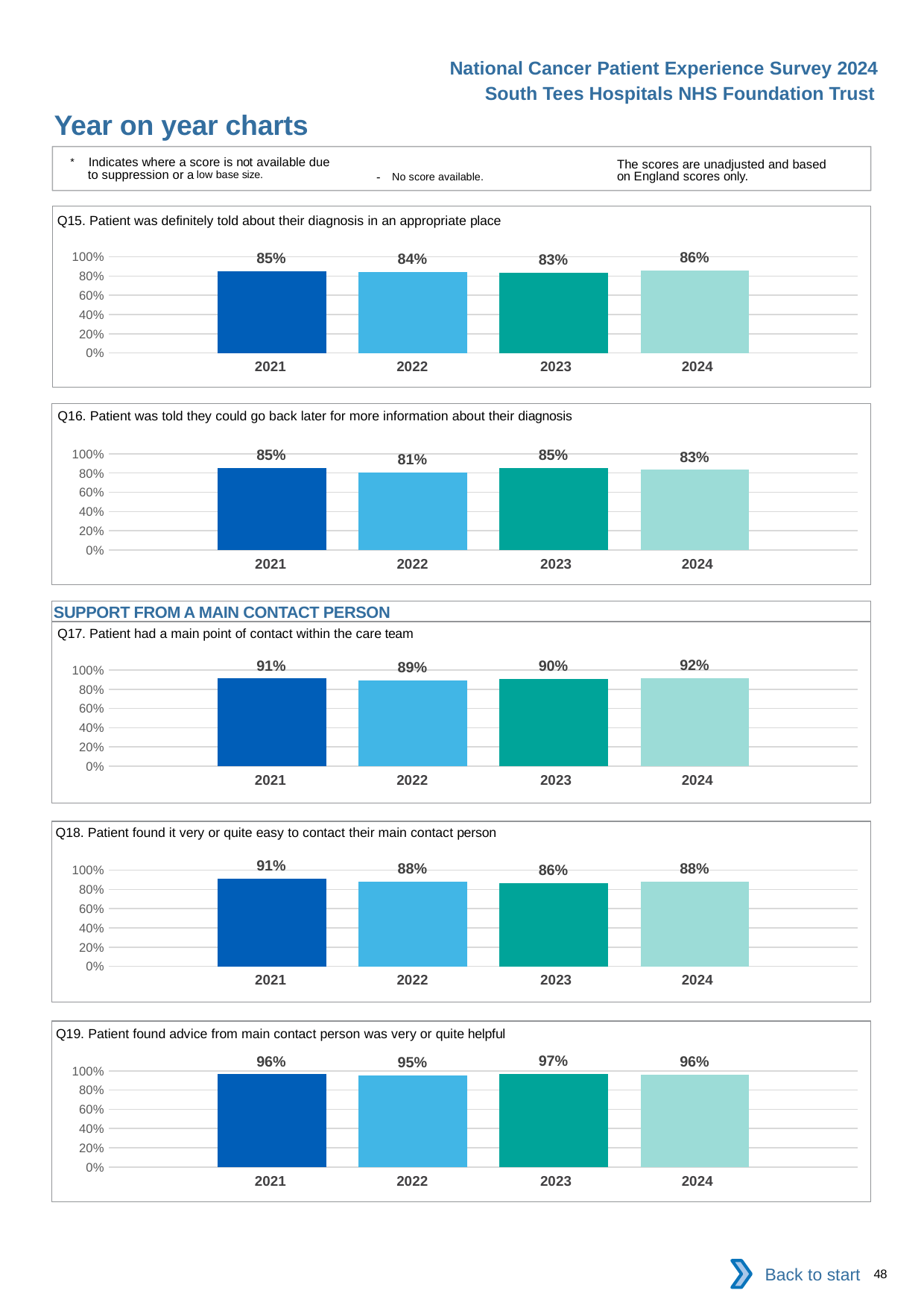
In the Q15 chart (Patient was definitely told about their diagnosis in an appropriate place), what is the value for 2024? 86% In the Q16 chart, what is the difference between the 2023 value and the 2024 value? 2 percentage points How many years (categories) are shown in the Q15 chart? 4 What type of chart is used for Q17? Bar chart In the Q17 chart (Patient had a main point of contact within the care team), which year has the highest value? 2024 In the Q18 chart (Patient found it very or quite easy to contact their main contact person), which is larger, the value for 2021 or the value for 2023? 2021 In the Q16 chart (Patient was told they could go back later for more information about their diagnosis), what is the value for 2022? 81% In the Q17 chart, what is the value for 2022? 89% In the Q15 chart, which year has the lowest value? 2023 In the Q19 chart, which year has the lowest value? 2022 In the Q18 chart, what is the difference between the 2021 value and the 2023 value? 5 percentage points In the Q19 chart (Patient found advice from main contact person was very or quite helpful), what is the value for 2023? 97%